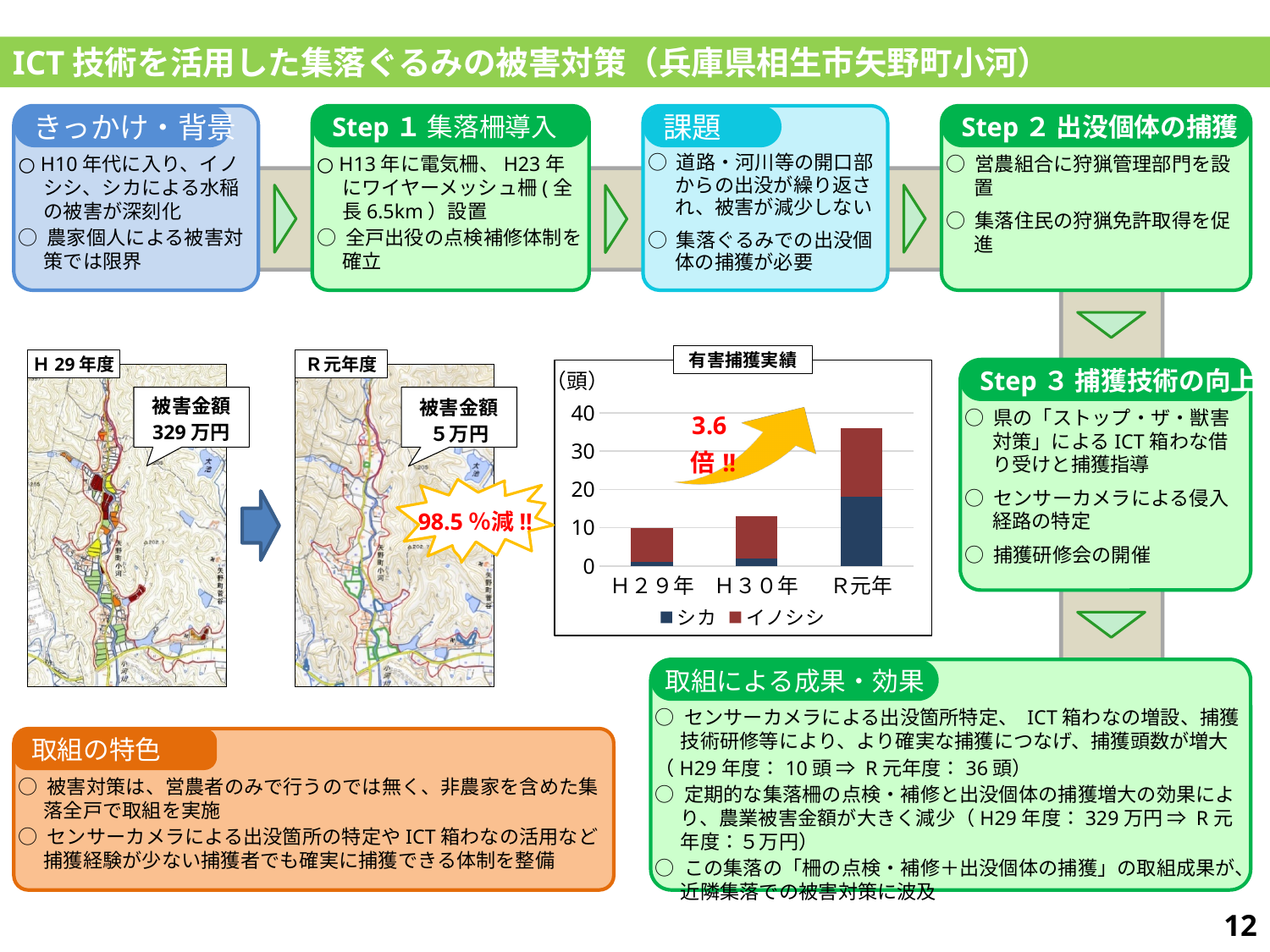
What type of chart is the 有害捕獲実績 chart? stacked bar chart In the 有害捕獲実績 chart, what is the total of the stacked bar for R元年? 36頭 In the 有害捕獲実績 chart, is the value for シカ in R元年 greater or less than 20? less Which series are listed in the legend of the 有害捕獲実績 chart? シカ, イノシシ How many series does the legend of the 有害捕獲実績 chart list? 2 How many categories are shown on the x axis of the 有害捕獲実績 chart? 3 In the 有害捕獲実績 chart, which year has the highest total catch? R元年 In the 有害捕獲実績 chart, which year has the lowest total catch? H29年 What is the title of the chart on the slide? 有害捕獲実績 In the 有害捕獲実績 chart, what is the total of the stacked bar for H29年? 10頭 In the 有害捕獲実績 chart, is the total for H30年 greater or less than 10? greater What is the unit shown on the y axis of the 有害捕獲実績 chart? 頭